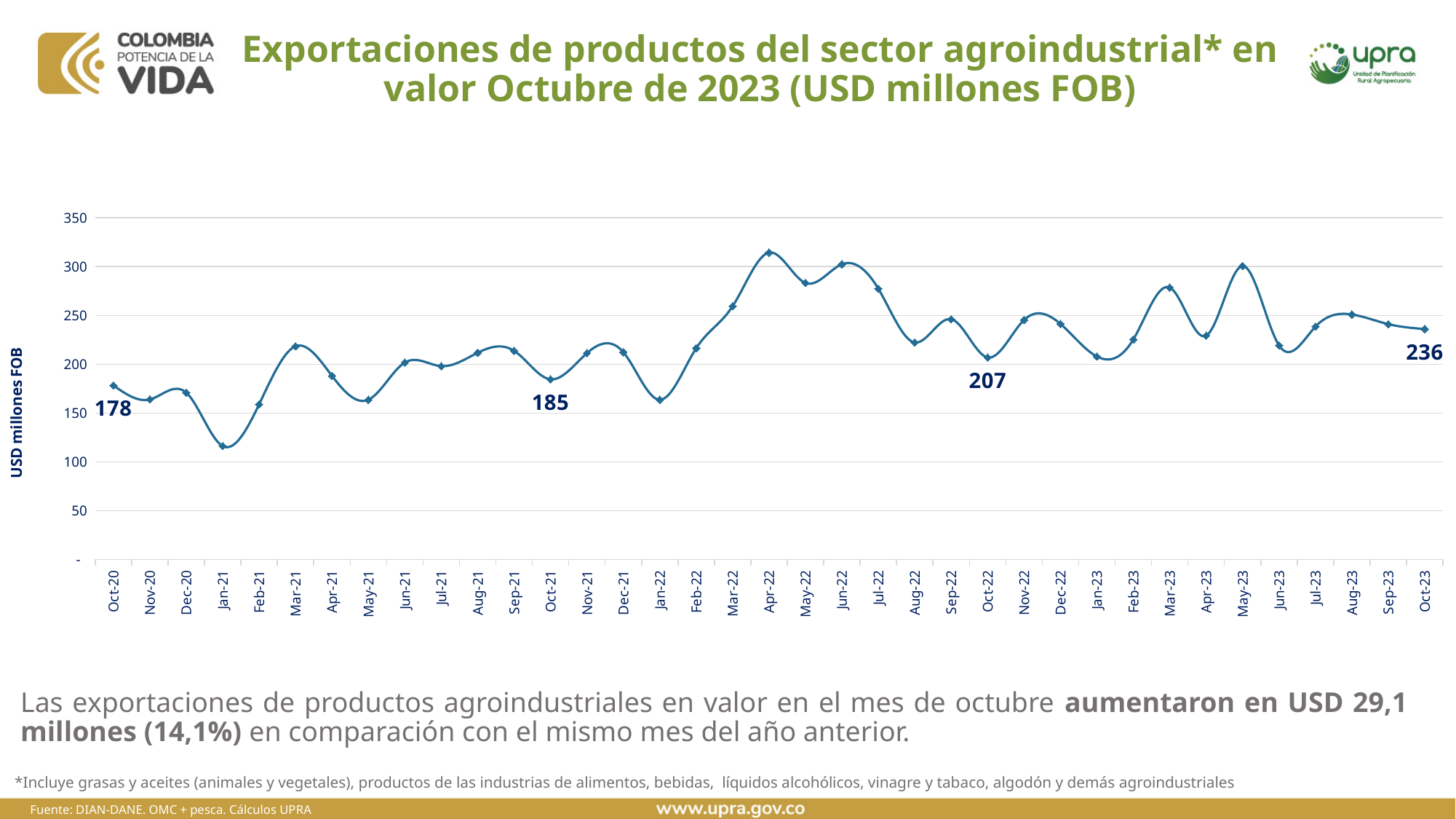
What is the label of the vertical axis? USD millones FOB What is the value for Oct-20? 178 What is the difference between the values for Oct-23 and Oct-22? 29 Which month has the lowest value on the chart? Jan-21 Is the value for Apr-22 greater or less than 300? greater Which is larger, the value for Oct-23 or the value for Oct-20? Oct-23 What is the value for Oct-21? 185 What is the value for Oct-22? 207 What is the value for Oct-23? 236 Which month has the highest value on the chart? Apr-22 What type of chart is shown on the slide? Line chart Is the value for Jan-21 greater or less than 150? less